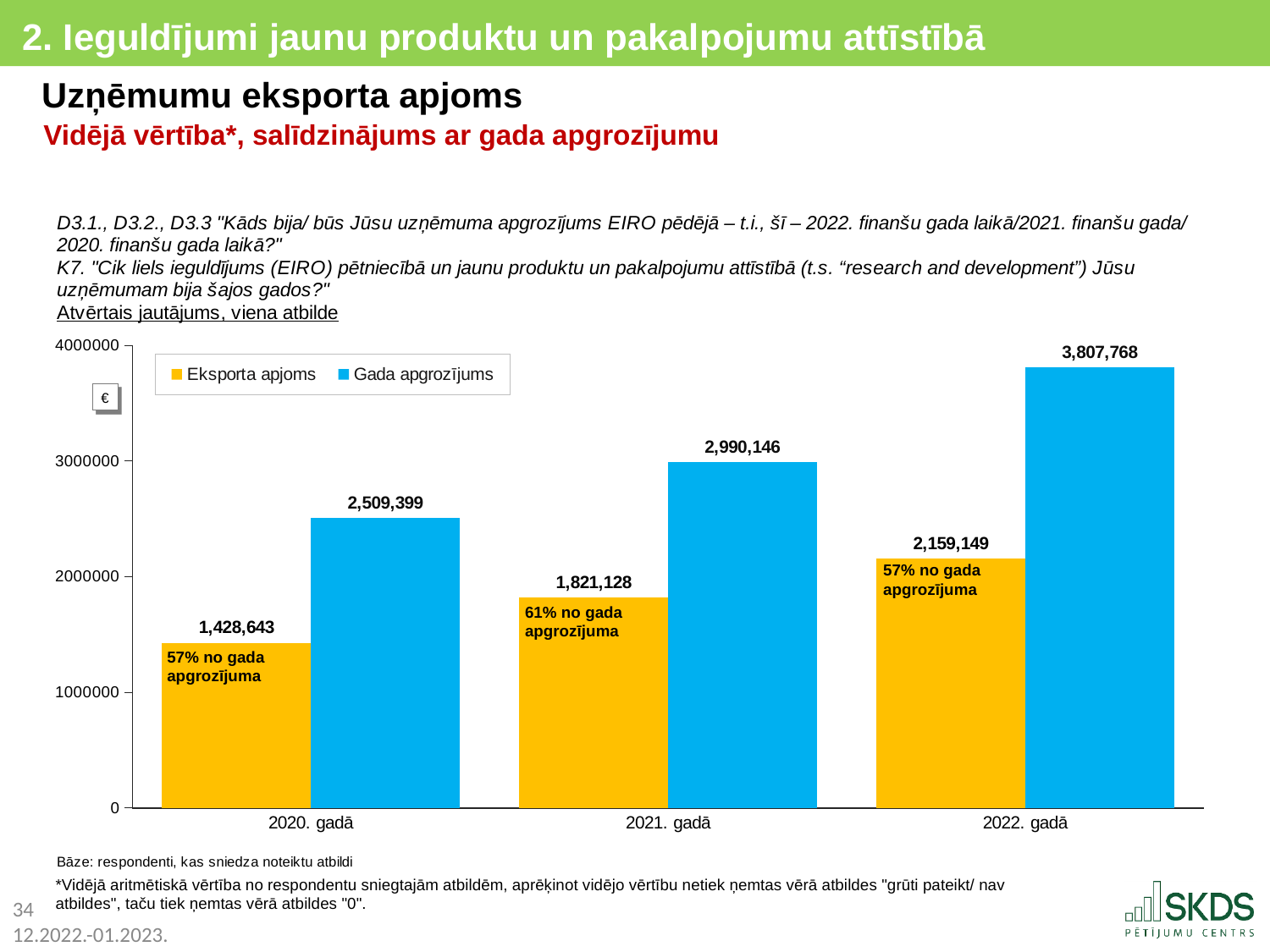
What is the value of Gada apgrozījums for 2021. gadā? 2,990,146 How many series does the legend list? 2 Which year has the lowest Gada apgrozījums? 2020. gadā What is the value of Eksporta apjoms for 2020. gadā? 1,428,643 Which year has the highest Eksporta apjoms? 2022. gadā Does Gada apgrozījums rise or fall from 2020. gadā to 2022. gadā? rise What is the value of Gada apgrozījums for 2022. gadā? 3,807,768 What is the difference between Gada apgrozījums and Eksporta apjoms in 2021. gadā? 1,169,018 How many years are shown on the x axis? 3 What kind of chart is shown? bar chart Is the value of Eksporta apjoms for 2021. gadā greater or less than 2000000? less Which is larger: Eksporta apjoms in 2022. gadā or Gada apgrozījums in 2020. gadā? Gada apgrozījums in 2020. gadā